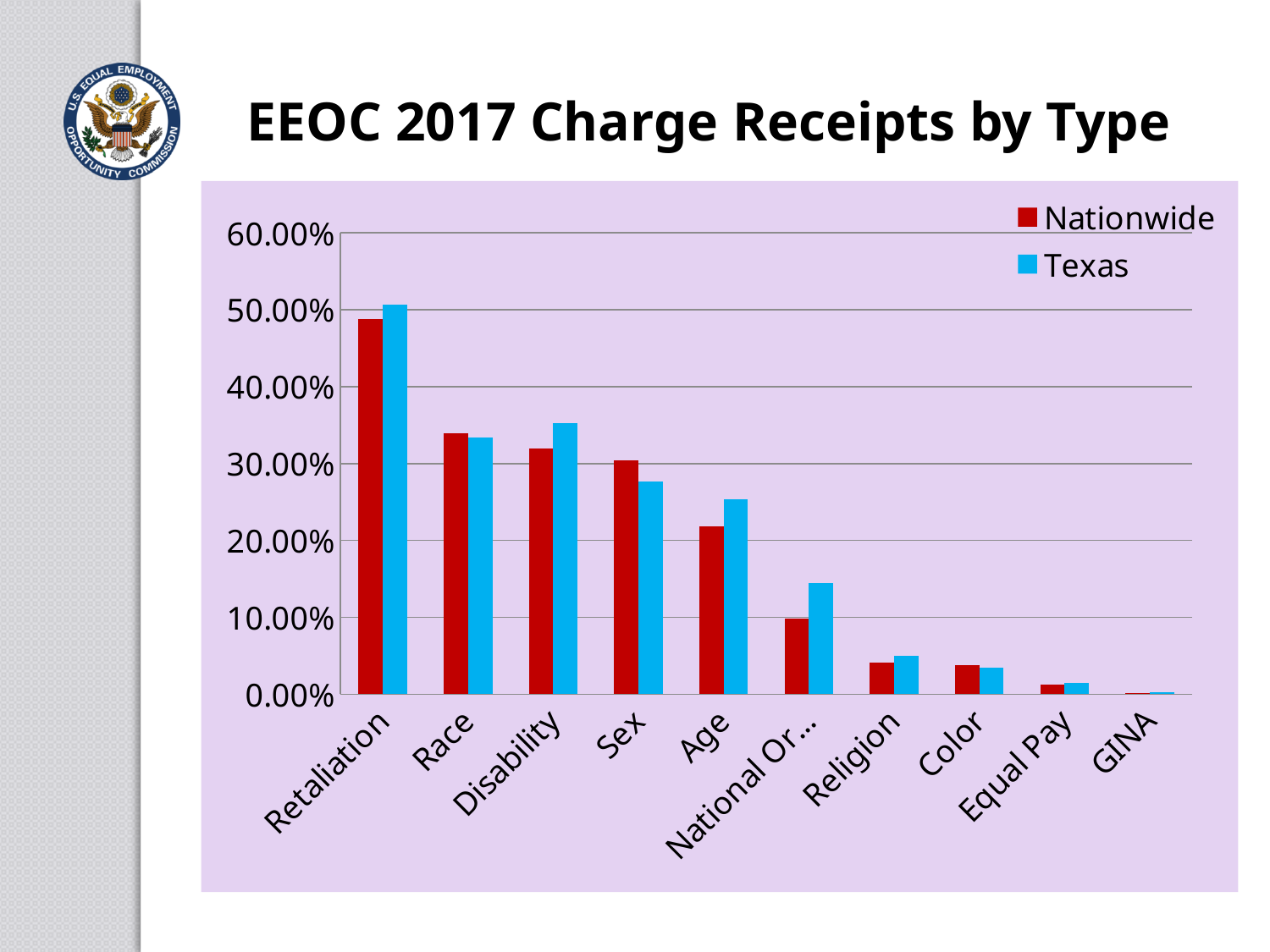
Which charge type has the highest Nationwide value? Retaliation Is the Texas value for Age greater or less than 20.00%? greater How many charge types are shown along the x axis? 10 What kind of chart is shown on the slide? bar chart For Sex, which is larger: the Nationwide value or the Texas value? Nationwide What is the title of the chart? EEOC 2017 Charge Receipts by Type Which charge type has the lowest Texas value? GINA Is the Nationwide value for Retaliation greater or less than 40.00%? greater Do the Nationwide values rise or fall moving from Retaliation to GINA along the x axis? fall Is the Texas value for National Or... greater or less than 10.00%? greater How many series does the legend list? 2 For Disability, which is larger: the Nationwide value or the Texas value? Texas